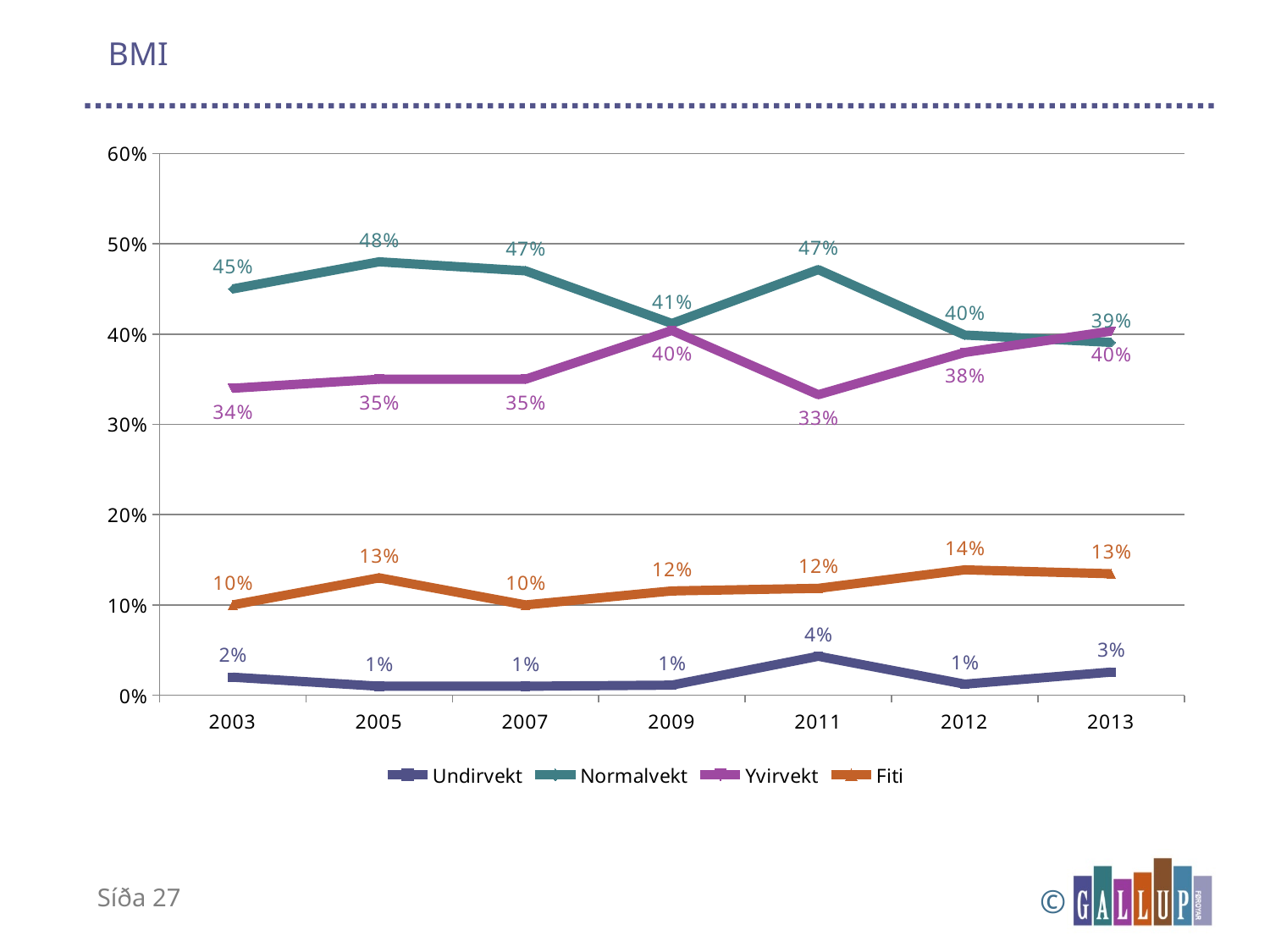
What is the value for Fiti in 2012? 14% What is the difference between Normalvekt and Yvirvekt in 2003? 11% How many series does the legend list? 4 Which is larger in 2013, Normalvekt or Yvirvekt? Yvirvekt What is the value for Normalvekt in 2005? 48% How many years are shown on the x axis? 7 Which series is drawn in orange? Fiti What type of chart is shown on the slide? line chart In which year is Normalvekt at its highest? 2005 What is the value for Yvirvekt in 2011? 33% What is the value for Undirvekt in 2011? 4% In which year is Yvirvekt at its lowest? 2011